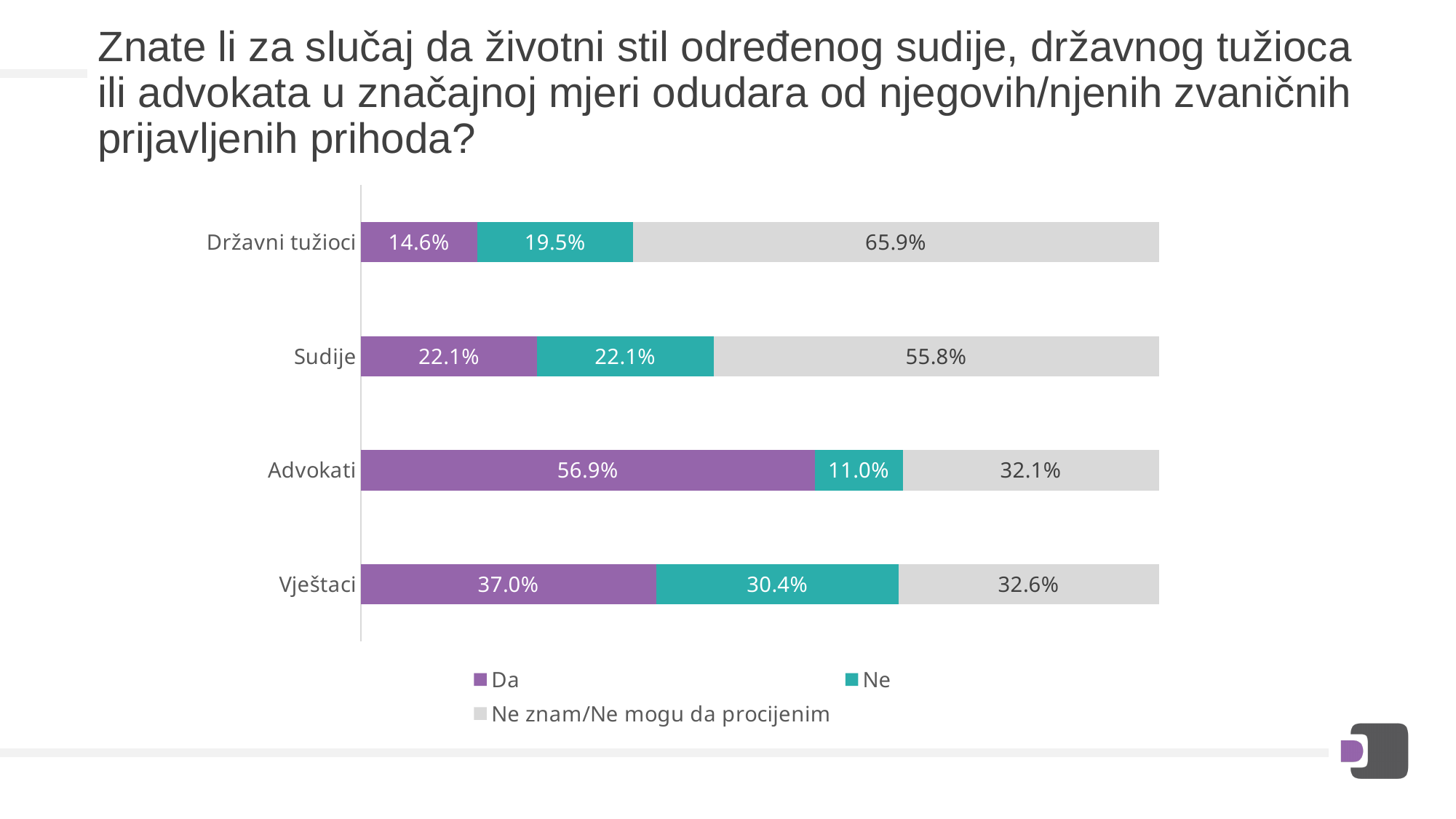
What is the difference between the 'Da' values for Advokati and Vještaci? 19.9% What kind of chart is shown on the slide? Stacked bar chart Which is larger: the 'Ne znam/Ne mogu da procijenim' value for Sudije or for Vještaci? Sudije What is the 'Ne znam/Ne mogu da procijenim' value for Državni tužioci? 65.9% What is the 'Ne' value for Vještaci? 30.4% Which series is shown in purple? Da How many categories are shown on the chart? 4 How many series does the legend list? 3 What is the 'Da' value for Advokati? 56.9% Which category has the lowest 'Ne' value? Advokati Which category has the lowest 'Da' value? Državni tužioci Which category has the highest 'Da' value? Advokati